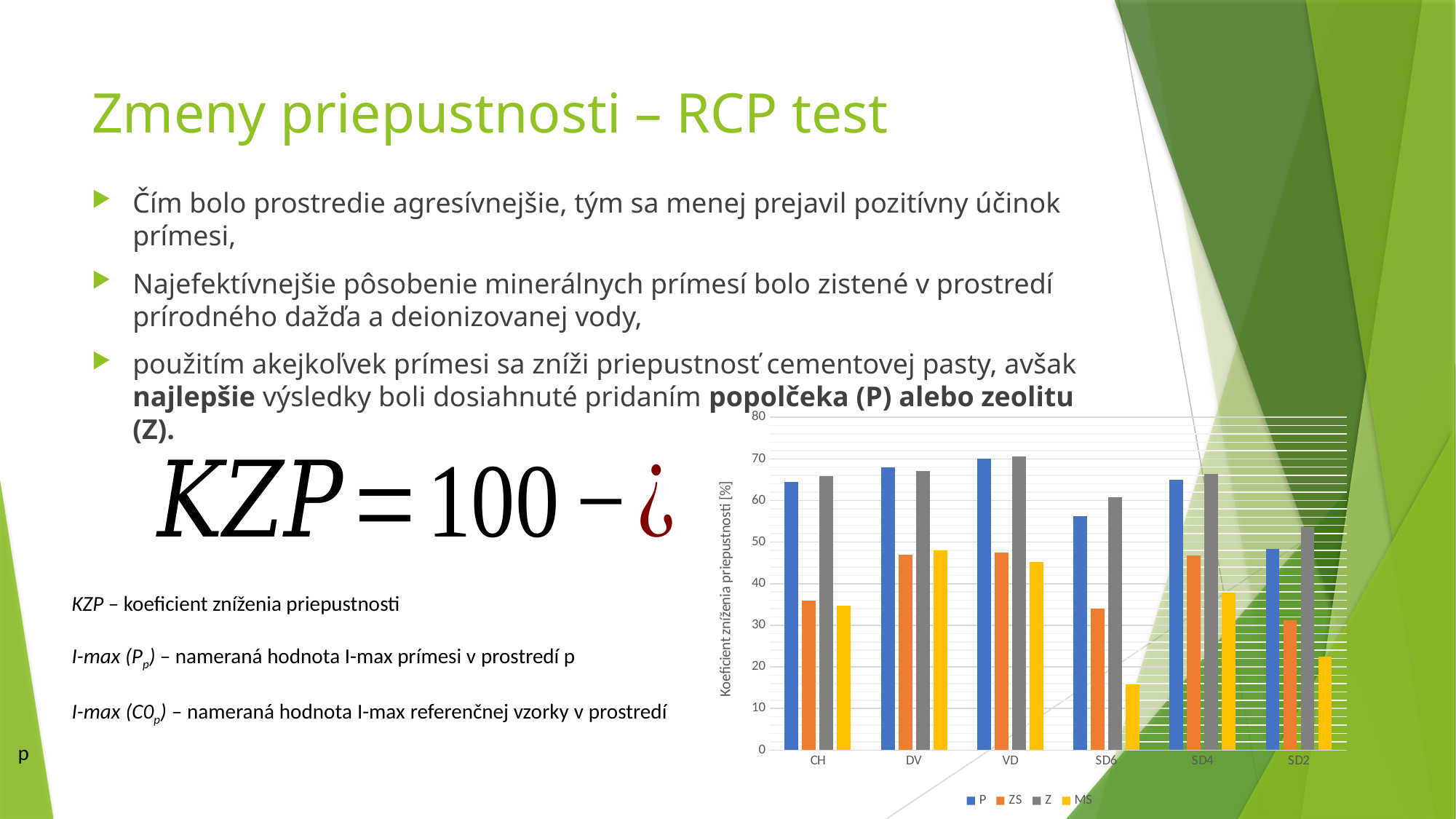
Is the value for P in category CH greater or less than 60? greater Is the value for MS in category SD6 greater or less than 20? less In category CH, which is larger: the value for Z or the value for ZS? Z How many categories are shown on the x axis of the chart? 6 For which category is the P series lowest? SD2 Is the value for ZS in category DV greater or less than 50? less What is the label of the vertical axis of the chart? Koeficient zníženia priepustnosti [%] How many series does the chart legend list? 4 In category SD6, which is larger: the value for P or the value for MS? P What kind of chart is shown on the slide? bar chart Which series are listed in the chart legend? P, ZS, Z, MS For which category is the MS series lowest? SD6